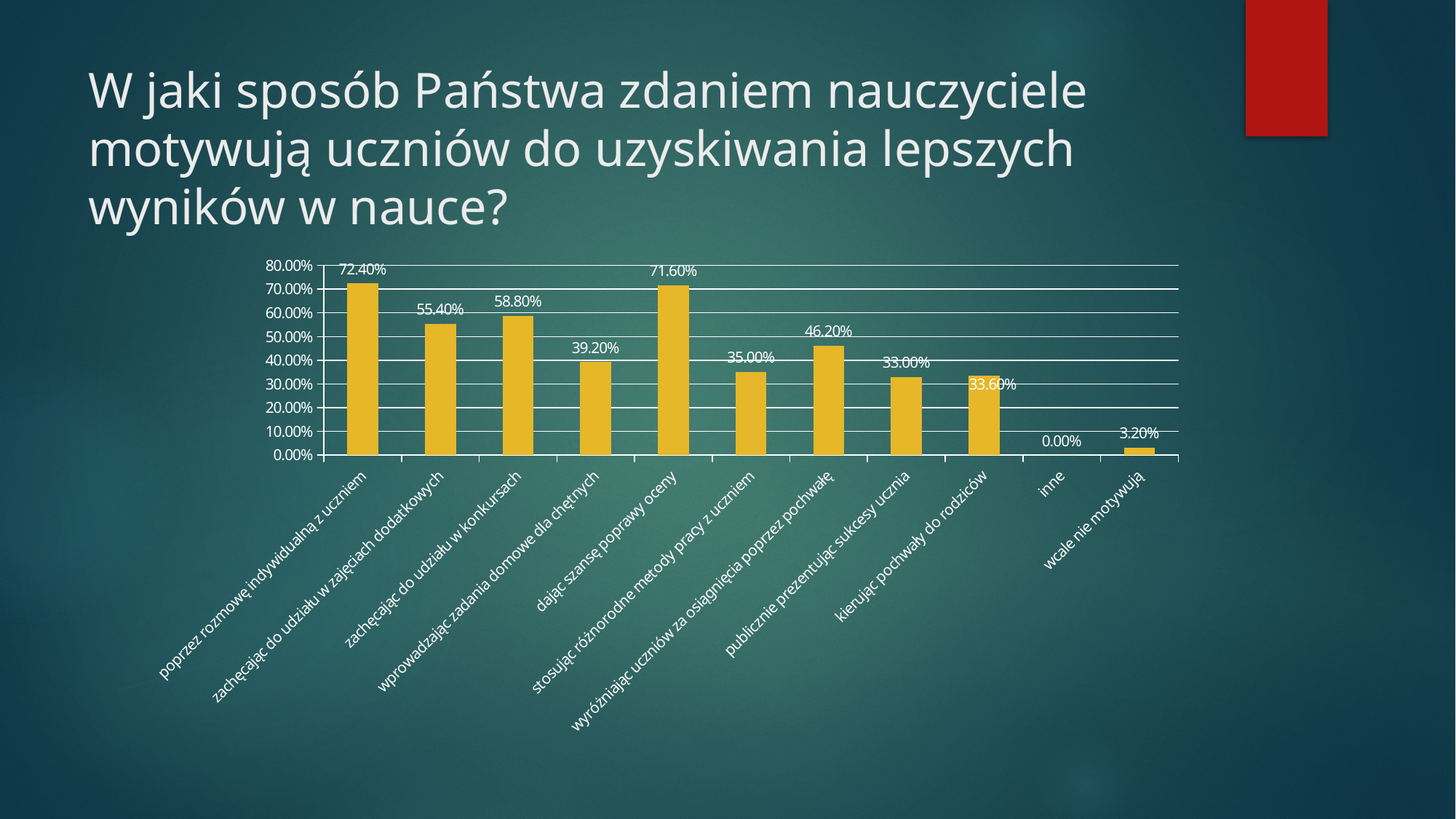
What is the value for "dając szansę poprawy oceny"? 71.60% What is the difference between "zachęcając do udziału w konkursach" and "zachęcając do udziału w zajęciach dodatkowych"? 3.40% Which category has the highest value? poprzez rozmowę indywidualną z uczniem What is the value for "wcale nie motywują"? 3.20% How many categories are shown on the x axis? 11 What percentage is shown for "wyróżniając uczniów za osiągnięcia poprzez pochwałę"? 46.20% Which is larger: "kierując pochwały do rodziców" or "publicznie prezentując sukcesy ucznia"? kierując pochwały do rodziców What colour are the bars in the chart? yellow What percentage is shown for "poprzez rozmowę indywidualną z uczniem"? 72.40% Which category has the lowest value? inne Is the value for "wprowadzając zadania domowe dla chętnych" greater or less than 40.00%? less What type of chart is shown on the slide? bar chart